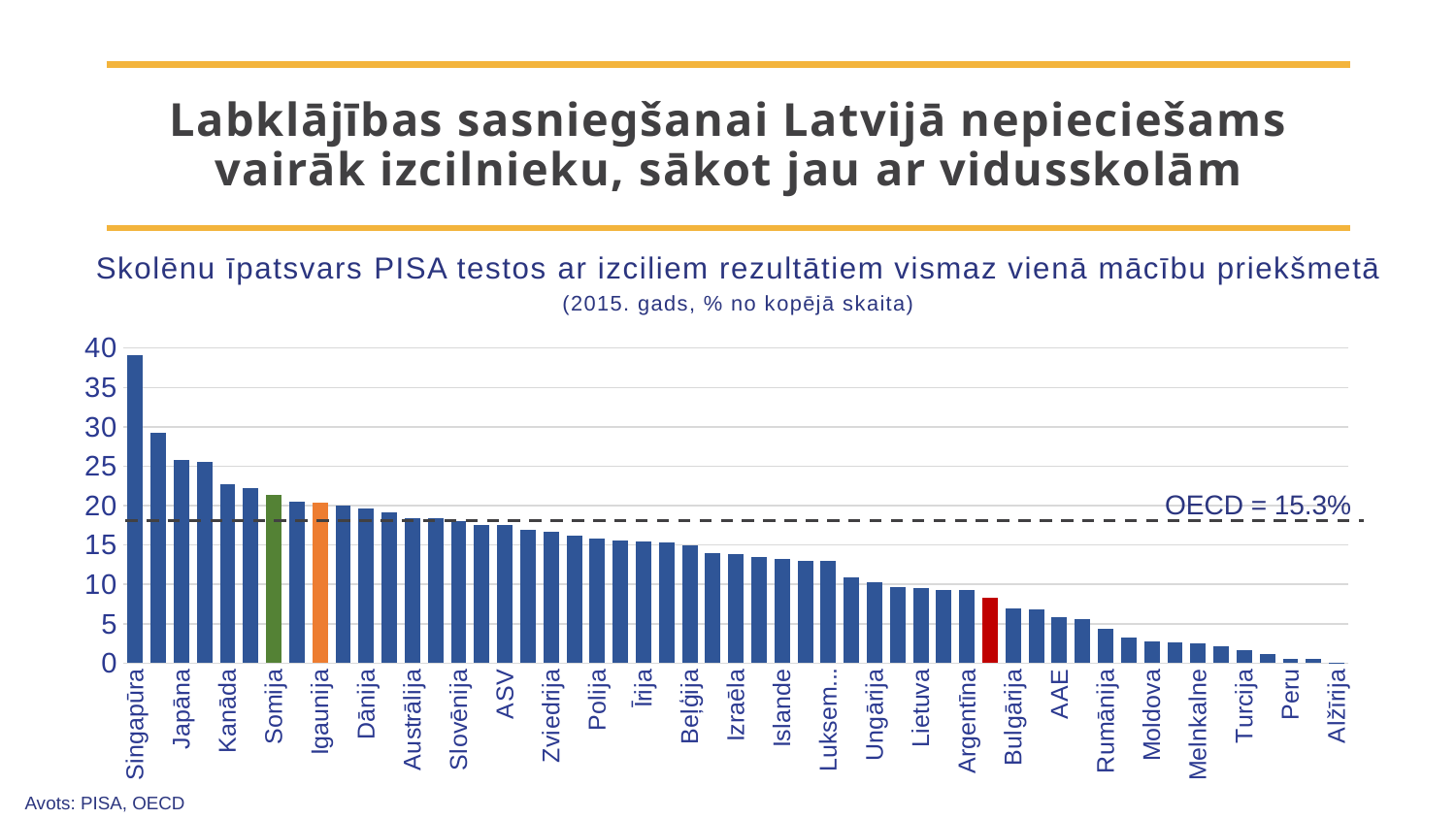
What OECD average value is marked by the dashed line on the chart? 15.3% Is the value for Turcija greater or less than 5? less Which labelled country has the lowest value in the chart? Alžīrija Is the value for Somija greater or less than 15? greater Which country has the highest share of students with excellent PISA results? Singapūra What kind of chart is shown on the slide? bar chart Is the value for Singapūra greater or less than 35? greater Which has a larger value, Kanāda or Lietuva? Kanāda Do the values rise or fall moving from left to right along the x axis? fall Which country's bar is coloured orange in the chart? Igaunija